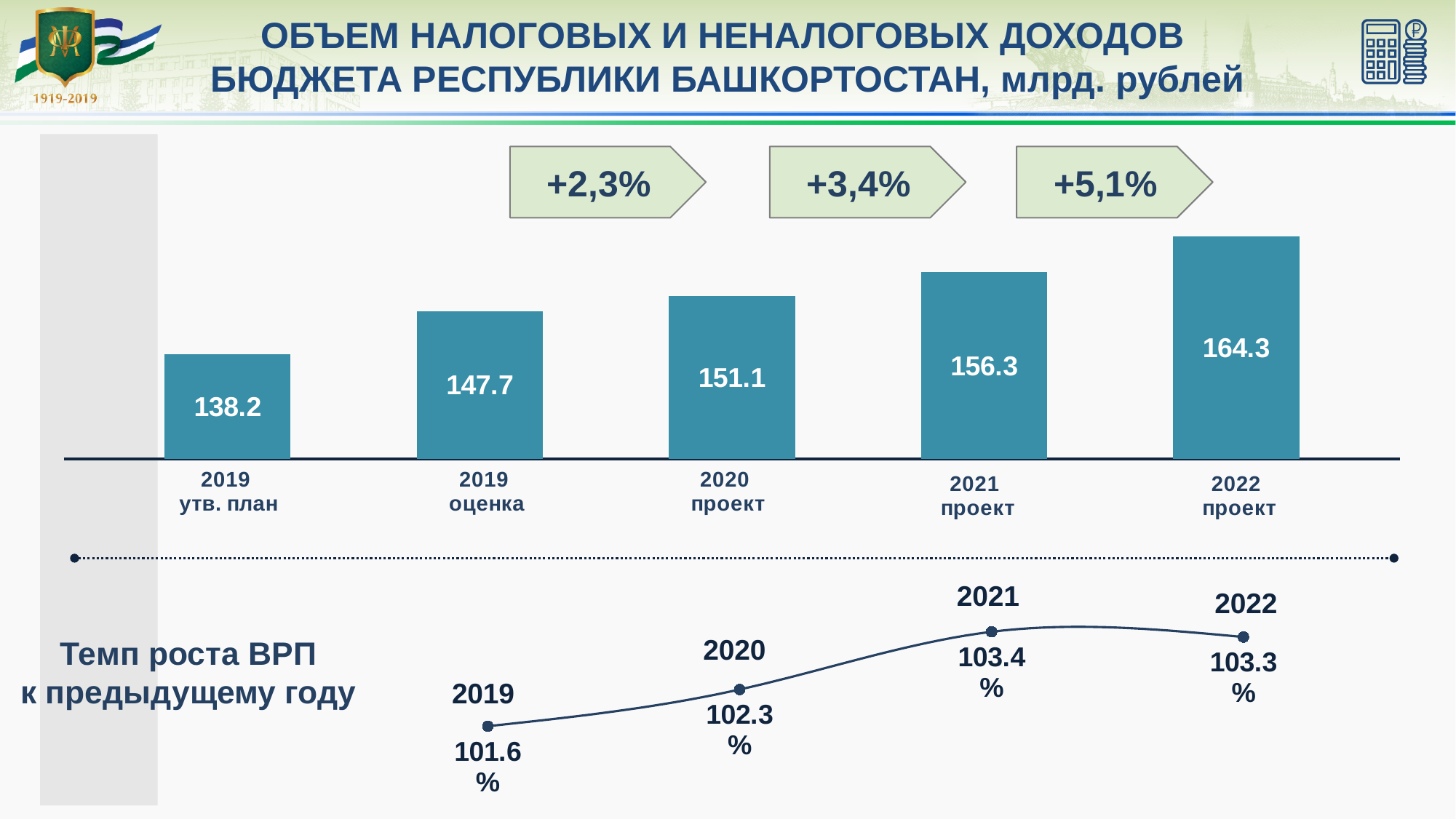
In the bar chart at the top of the slide, which is larger: the value for 2019 оценка or the value for 2020 проект? 2020 проект In the bar chart at the top of the slide, do the values rise or fall from left to right? rise In the bar chart at the top of the slide, what is the value for 2020 проект? 151.1 In the bar chart at the top of the slide, which category has the highest value? 2022 проект What kind of chart is shown at the top of the slide? bar chart In the line chart at the bottom of the slide (Темп роста ВРП к предыдущему году), what is the value for 2021? 103.4% In the bar chart at the top of the slide, what is the difference between the values for 2022 проект and 2021 проект? 8.0 What kind of chart is shown at the bottom of the slide (Темп роста ВРП к предыдущему году)? line chart In the bar chart at the top of the slide, what is the value for 2019 утв. план? 138.2 In the line chart at the bottom of the slide (Темп роста ВРП к предыдущему году), which year has the lowest value? 2019 How many bars are in the bar chart at the top of the slide? 5 In the bar chart at the top of the slide, which category has the lowest value? 2019 утв. план